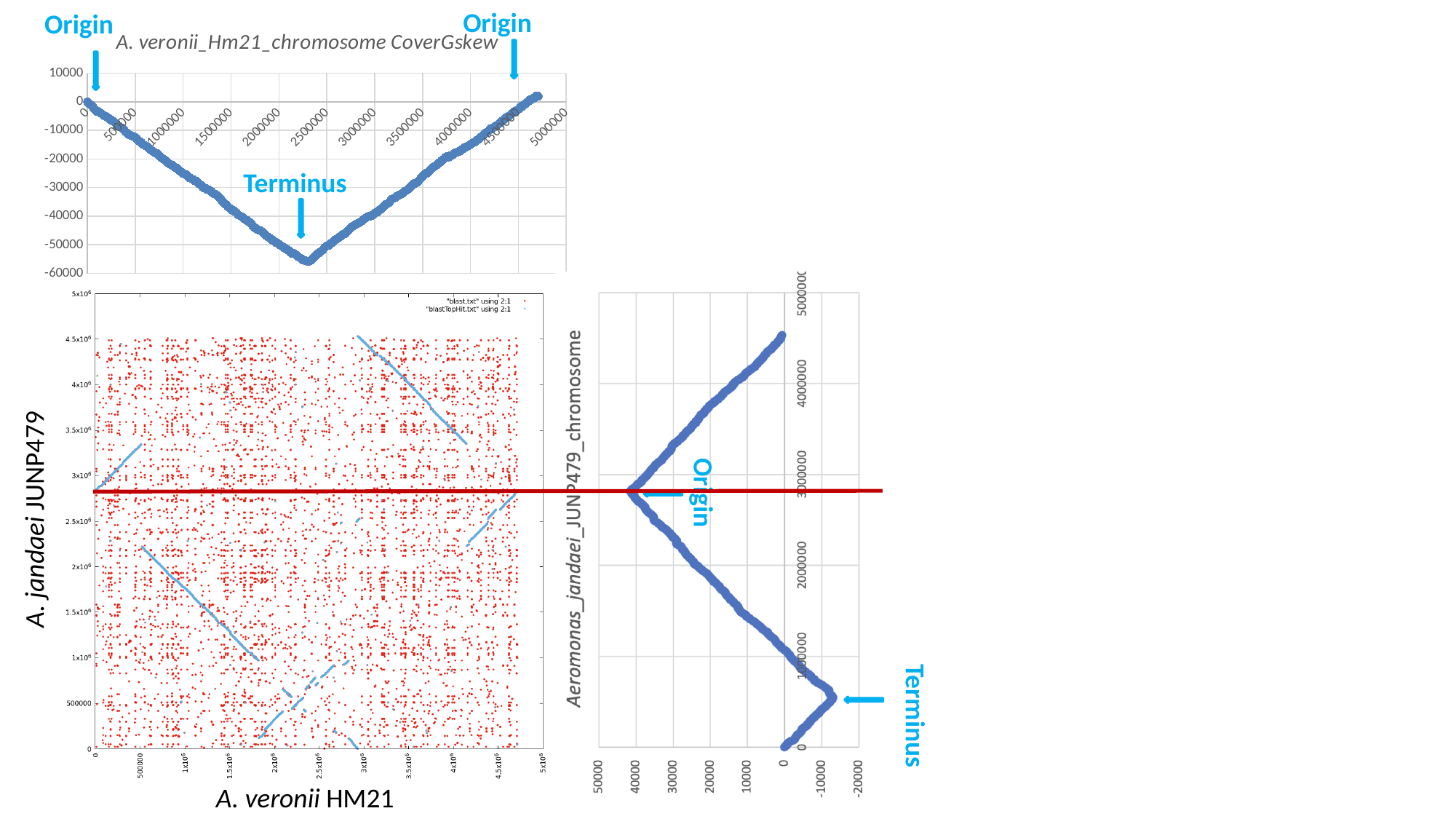
How many series does the legend of the bottom-left dot plot list? 2 In the A. veronii_Hm21_chromosome CoverGskew chart, do the values rise or fall along the x axis between 0 and 2500000? fall What is the title of the chart at the top left of the slide? A. veronii_Hm21_chromosome CoverGskew In the Aeromonas_jandaei_JUNP479_chromosome chart, is the value at the Terminus greater or less than 0? less What is the label on the x axis of the bottom-left dot plot? A. veronii HM21 In the A. veronii_Hm21_chromosome CoverGskew chart, is the value at the Terminus (around 2500000) greater or less than -50000? less What kind of chart is the bottom-left plot comparing A. veronii HM21 and A. jandaei JUNP479? scatter plot In the Aeromonas_jandaei_JUNP479_chromosome chart, is the value at the Origin (around 2900000) greater or less than 30000? greater In the A. veronii_Hm21_chromosome CoverGskew chart, what is the lowest value shown on the y axis? -60000 In the A. veronii_Hm21_chromosome CoverGskew chart, do the values rise or fall along the x axis between 2500000 and 5000000? rise